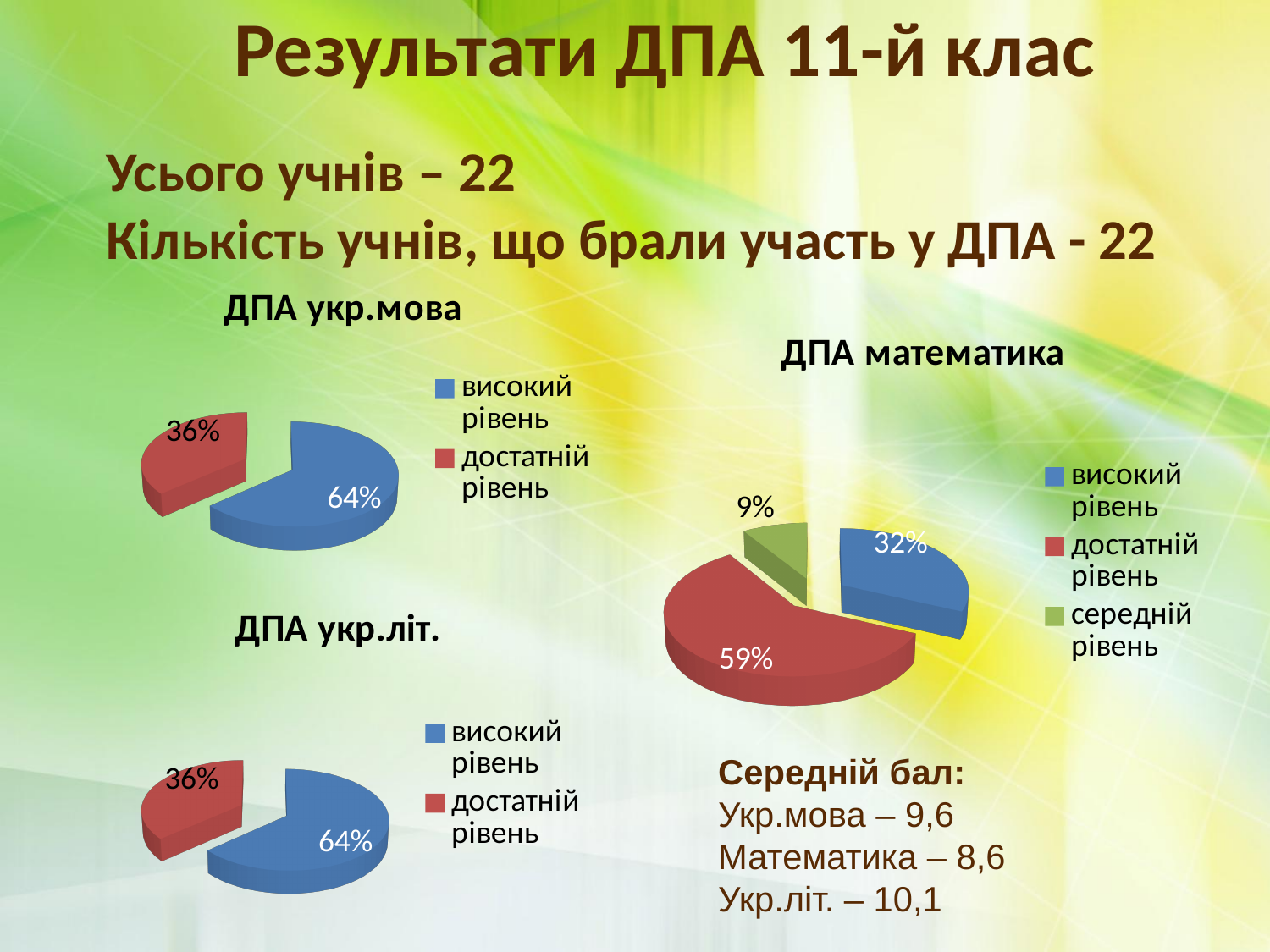
In the "ДПА математика" chart, which level has the smallest slice? середній рівень In the "ДПА математика" chart, what share is labelled for "середній рівень"? 9% In the "ДПА математика" chart, which level has the largest slice? достатній рівень In the "ДПА математика" chart, what is the difference between the shares for "достатній рівень" and "високий рівень"? 27% In the "ДПА укр.літ." chart, which level has the larger slice? високий рівень In the "ДПА укр.мова" chart, what share is labelled for "достатній рівень"? 36% In the "ДПА математика" chart, what share is labelled for "достатній рівень"? 59% In the "ДПА укр.літ." chart, what is the difference between the shares for "високий рівень" and "достатній рівень"? 28% How many slices does the "ДПА математика" chart have? 3 In the "ДПА укр.мова" chart, what share is labelled for "високий рівень"? 64% How many entries does the legend of the "ДПА укр.літ." chart list? 2 What type of chart is "ДПА укр.мова"? Pie chart